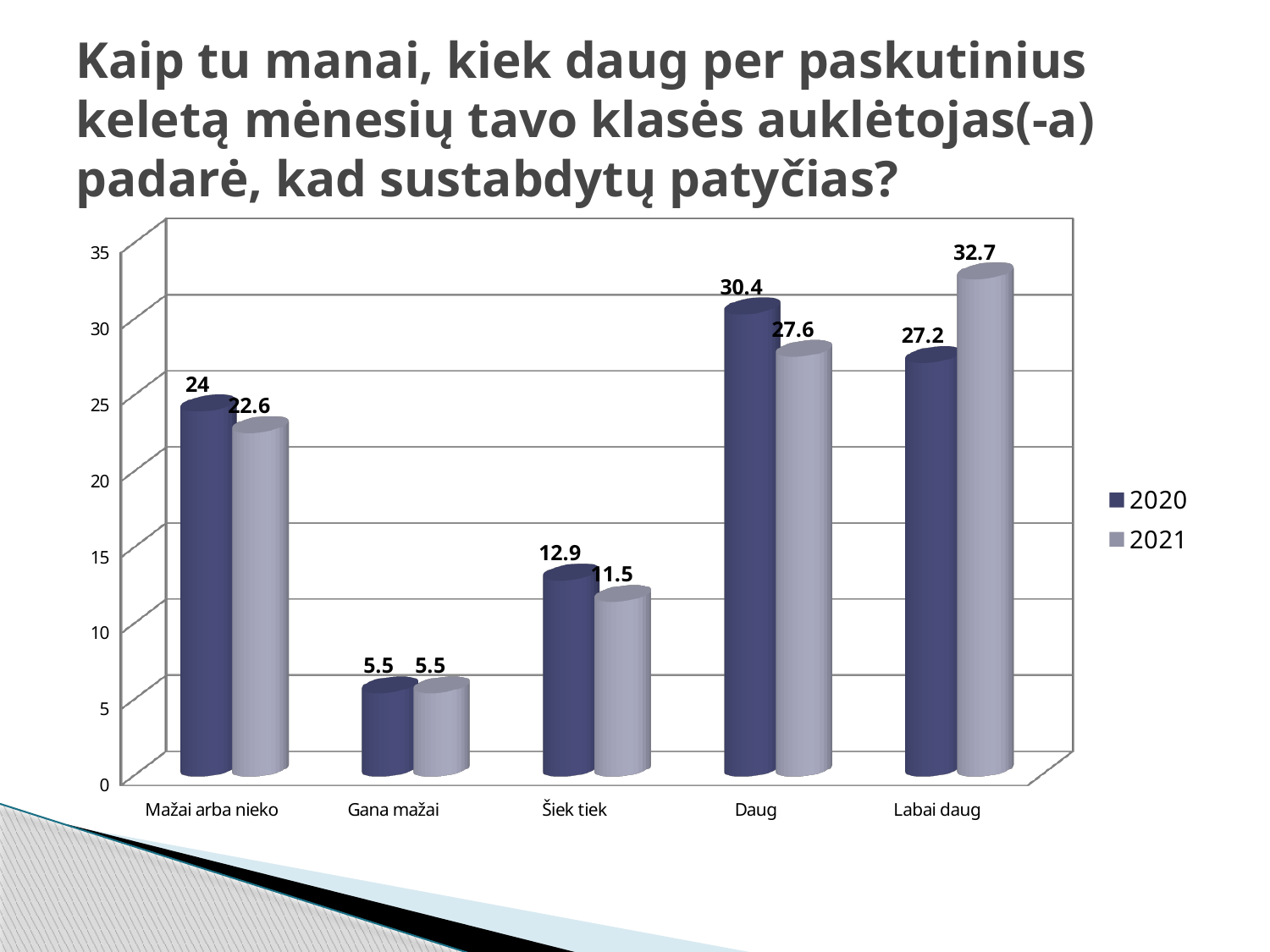
Which category has the highest value in the 2021 series? Labai daug Which category has the lowest value in the 2020 series? Gana mažai How many series does the legend list? 2 What is the value for "Daug" in the 2020 series? 30.4 What is the value for "Labai daug" in the 2021 series? 32.7 How many categories are shown on the x axis? 5 What is the value for "Šiek tiek" in the 2021 series? 11.5 What kind of chart is shown on the slide? Bar chart Which is larger for "Daug": the 2020 value or the 2021 value? 2020 What is the difference between the 2021 and 2020 values for "Labai daug"? 5.5 What is the difference between the 2020 and 2021 values for "Mažai arba nieko"? 1.4 Which series is shown in the lighter grey colour in the legend? 2021